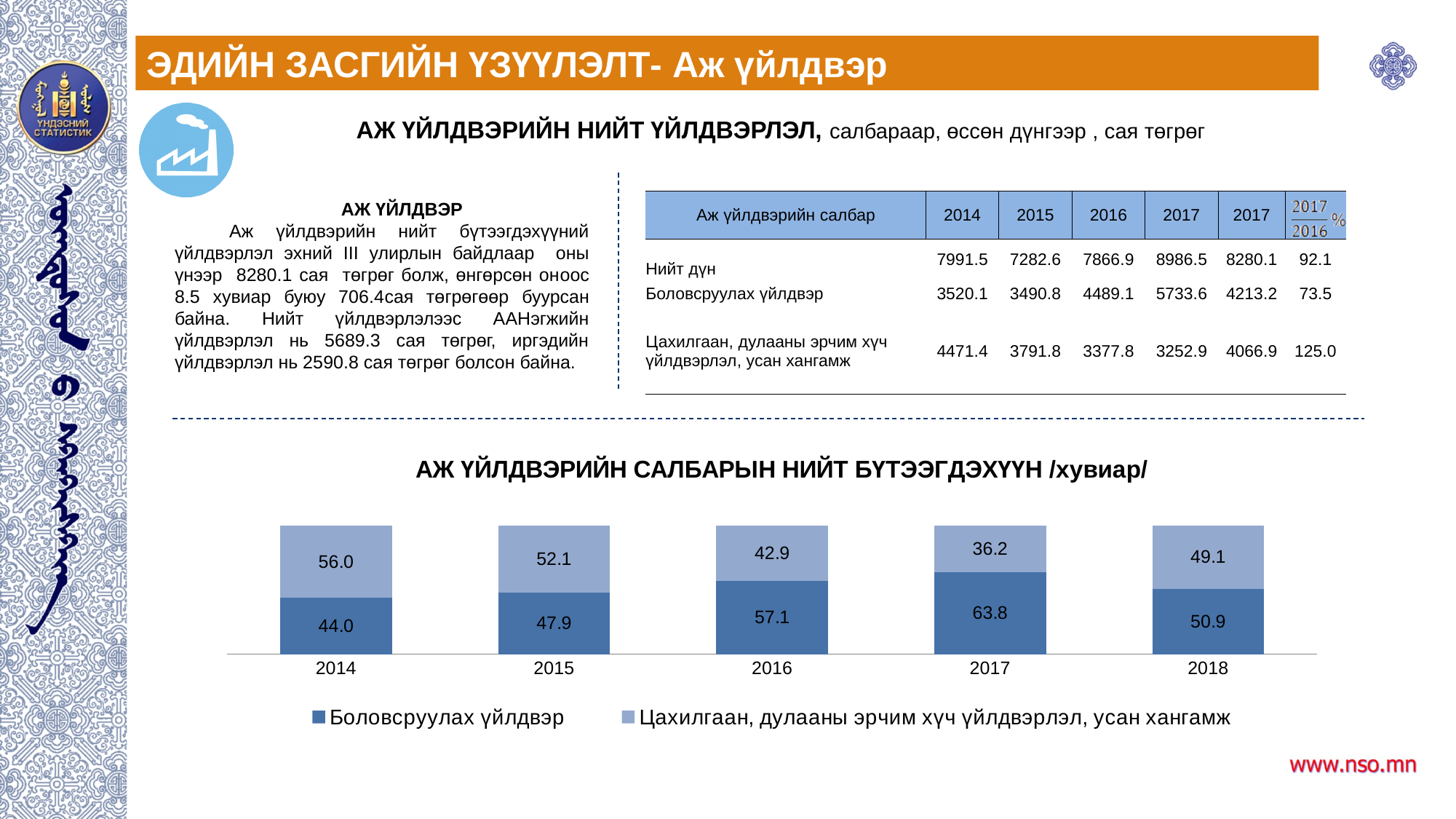
In the bar chart, what is the value for Боловсруулах үйлдвэр in 2018? 50.9 How many series does the legend of the bar chart list? 2 In the bar chart, which year has the highest value for Боловсруулах үйлдвэр? 2017 In the bar chart, does the value for Боловсруулах үйлдвэр rise or fall from 2014 to 2017? Rise How many years are shown on the x axis of the bar chart? 5 In the bar chart, which is larger in 2018: Боловсруулах үйлдвэр or Цахилгаан, дулааны эрчим хүч үйлдвэрлэл, усан хангамж? Боловсруулах үйлдвэр What type of chart is shown under the title "АЖ ҮЙЛДВЭРИЙН САЛБАРЫН НИЙТ БҮТЭЭГДЭХҮҮН /хувиар/"? Stacked bar chart In the bar chart, what is the value for Цахилгаан, дулааны эрчим хүч үйлдвэрлэл, усан хангамж in 2014? 56.0 In the bar chart, what is the difference between the Боловсруулах үйлдвэр values for 2016 and 2015? 9.2 In the bar chart, what is the value for Боловсруулах үйлдвэр in 2017? 63.8 In the bar chart, what is the total of the stacked bar for 2016? 100.0 In the bar chart, which year has the lowest value for Цахилгаан, дулааны эрчим хүч үйлдвэрлэл, усан хангамж? 2017